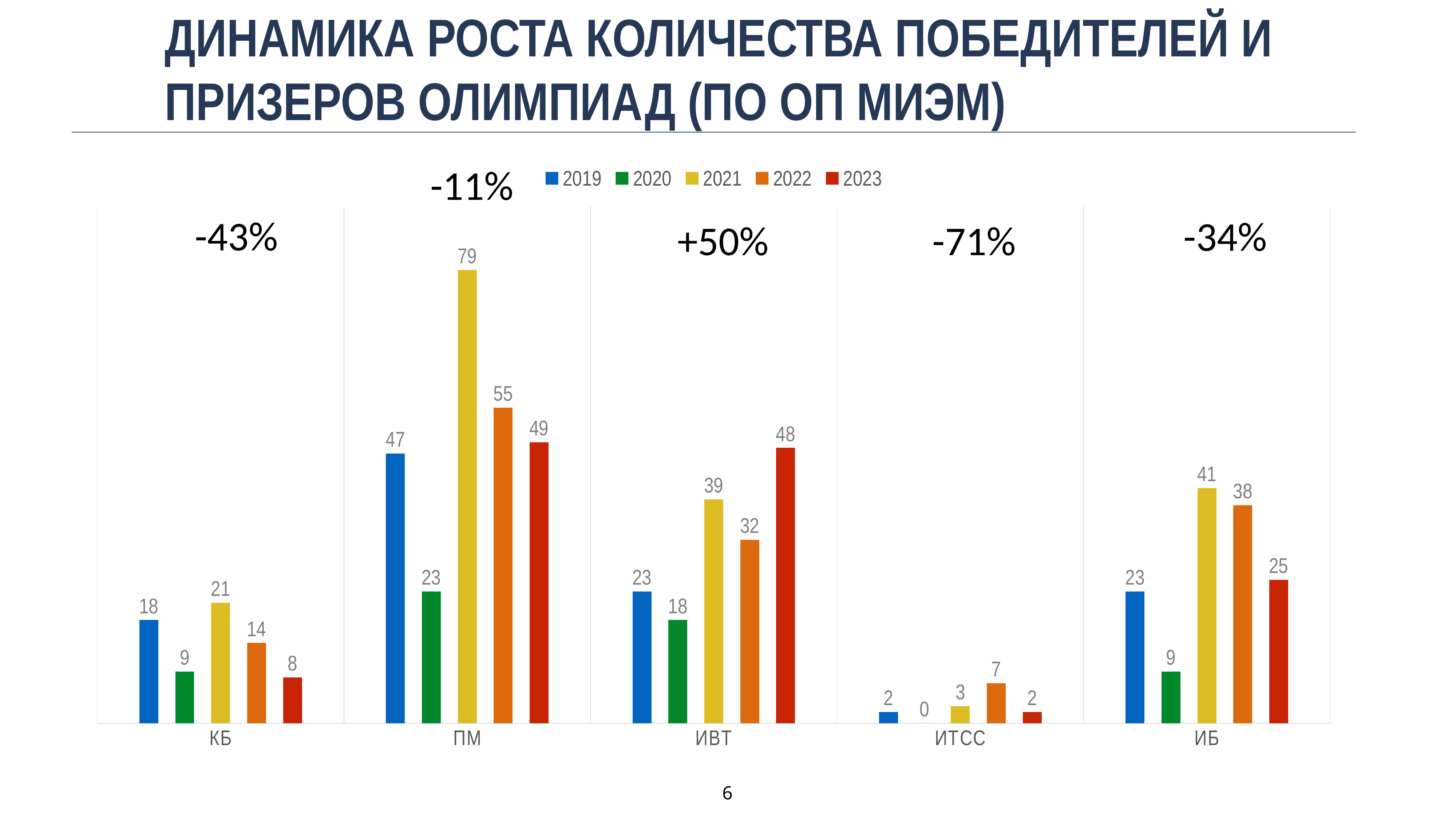
Which category has the lowest value in 2019? ИТСС What is the value for ИВТ in 2023? 48 What is the value for ИТСС in 2020? 0 Do the values for ИВТ rise or fall from 2021 to 2023? rise What type of chart is shown on the slide? bar chart How many series does the legend list? 5 What is the value for ПМ in 2021? 79 What is the difference between the 2021 and 2023 values for КБ? 13 Which category has the highest value in 2022? ПМ Which is larger: the 2022 value for ИБ or the 2022 value for ИВТ? ИБ How many categories are shown on the x axis? 5 What percentage change is annotated above the ИТСС category? -71%